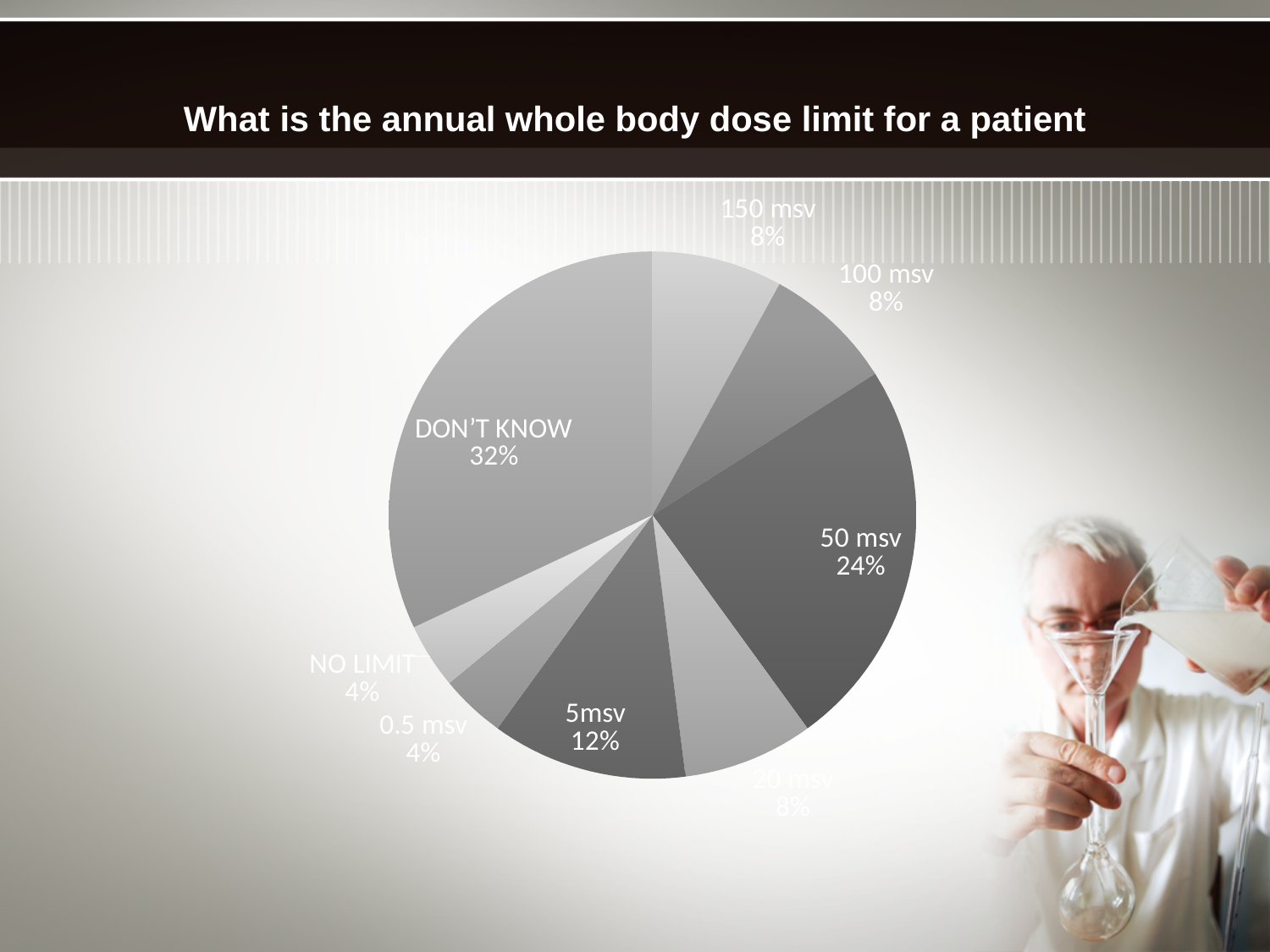
What is the difference between the DON'T KNOW share and the 50 msv share? 8% What share of the pie is labelled 50 msv? 24% Which slice of the pie is the largest? DON'T KNOW What share of the pie is labelled DON'T KNOW? 32% What share of the pie is labelled NO LIMIT? 4% What share of the pie is labelled 0.5 msv? 4% What is the combined share of the 150 msv, 100 msv and 20 msv slices? 24% Which is larger, the share for 5msv or the share for 20 msv? 5msv What share of the pie is labelled 5msv? 12% What is the title of the chart? What is the annual whole body dose limit for a patient What kind of chart is shown on the slide? pie chart How many slices does the pie chart have? 8